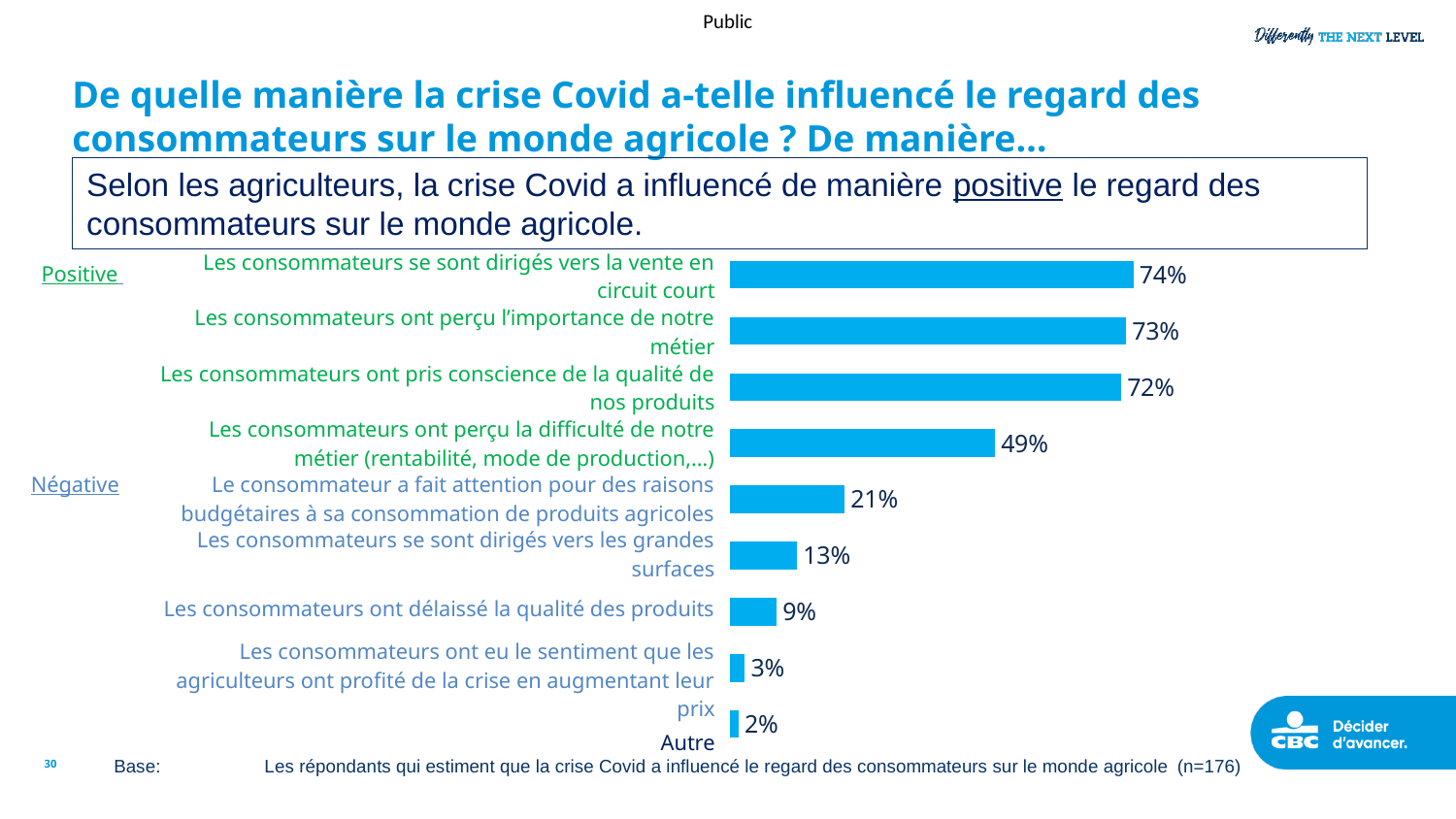
What kind of chart is shown on the slide? Bar chart Do the bar values rise or fall going from the top of the chart to the bottom? Fall Which is larger: the value for "Le consommateur a fait attention pour des raisons budgétaires à sa consommation de produits agricoles" or the value for "Les consommateurs ont délaissé la qualité des produits"? Le consommateur a fait attention pour des raisons budgétaires à sa consommation de produits agricoles Which category has the lowest value? Autre What is the value for "Les consommateurs se sont dirigés vers la vente en circuit court"? 74% What is the difference between the value for "Les consommateurs se sont dirigés vers la vente en circuit court" and the value for "Les consommateurs ont perçu la difficulté de notre métier"? 25 percentage points What is the value for "Les consommateurs ont perçu la difficulté de notre métier (rentabilité, mode de production,...)"? 49% What is the value for "Les consommateurs se sont dirigés vers les grandes surfaces"? 13% What is the value for "Autre"? 2% What is the sample size (n) given in the base note below the chart? n=176 How many categories (bars) does the chart show? 9 Which category has the highest value? Les consommateurs se sont dirigés vers la vente en circuit court